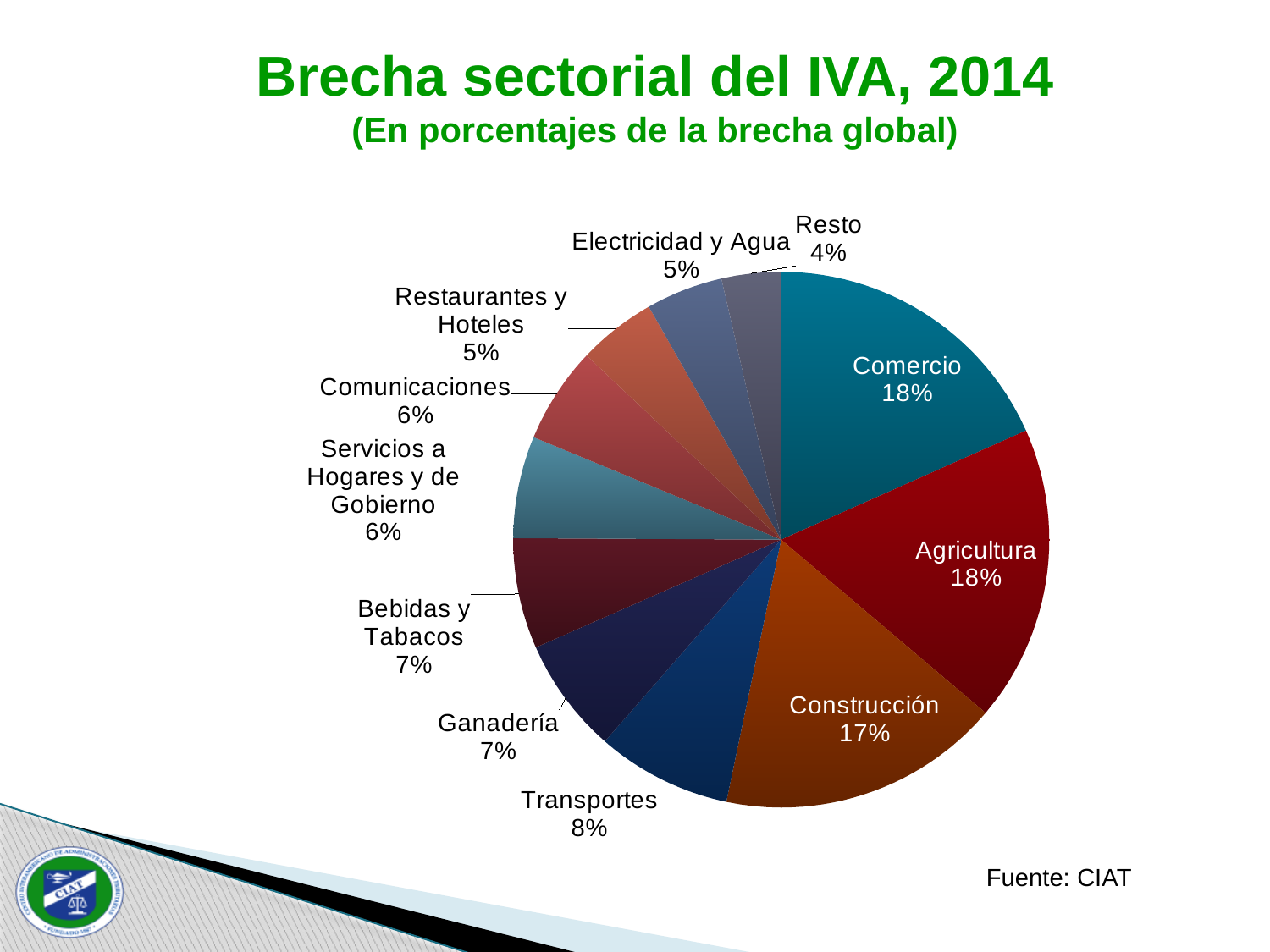
What percentage is shown for Construcción? 17% What is the title of the chart? Brecha sectorial del IVA, 2014 Which sector has the smallest share of the VAT gap? Resto What percentage is shown for Transportes? 8% What percentage is shown for Servicios a Hogares y de Gobierno? 6% Which is larger, the share for Construcción or the share for Ganadería? Construcción What is the difference in percentage points between Agricultura and Transportes? 10% What source is cited for the chart? CIAT What kind of chart is shown on the slide? Pie chart What share of the global VAT gap does Comercio account for? 18% What percentage is shown for Electricidad y Agua? 5% How many sectors (slices) are shown in the pie chart? 11